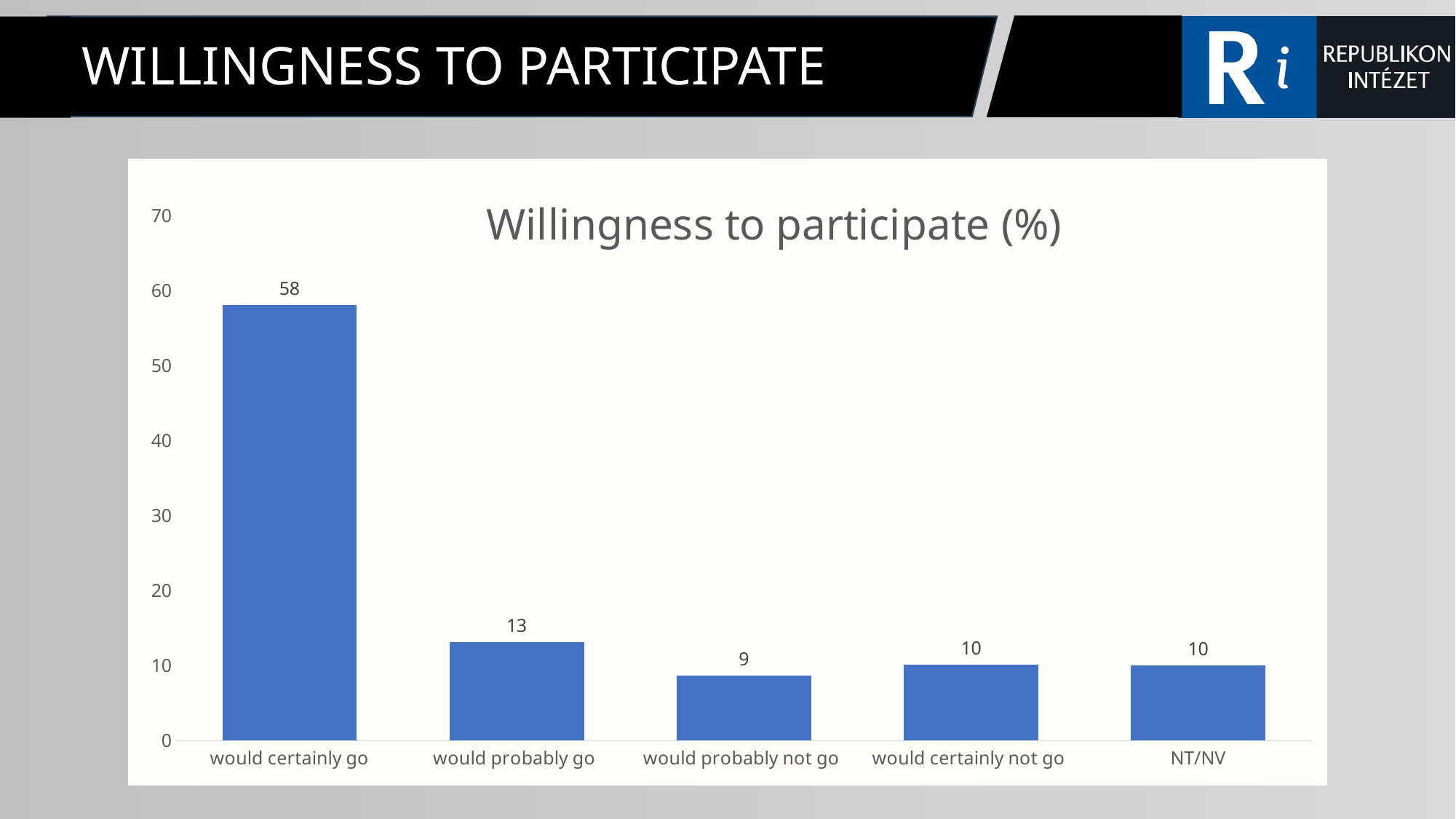
Which category has the highest value? would certainly go Which category has the lowest value? would probably not go What is the value for "would certainly go"? 58 What is the title of the chart? Willingness to participate (%) What is the value for "would probably not go"? 9 What is the difference between the values for "would certainly go" and "would probably go"? 45 What is the value for "would probably go"? 13 What is the value for "NT/NV"? 10 Is the value for "would certainly go" greater or less than 50? greater How many categories are shown on the x axis? 5 What kind of chart is shown on the slide? bar chart Which is larger, the value for "would probably go" or the value for "would certainly not go"? would probably go